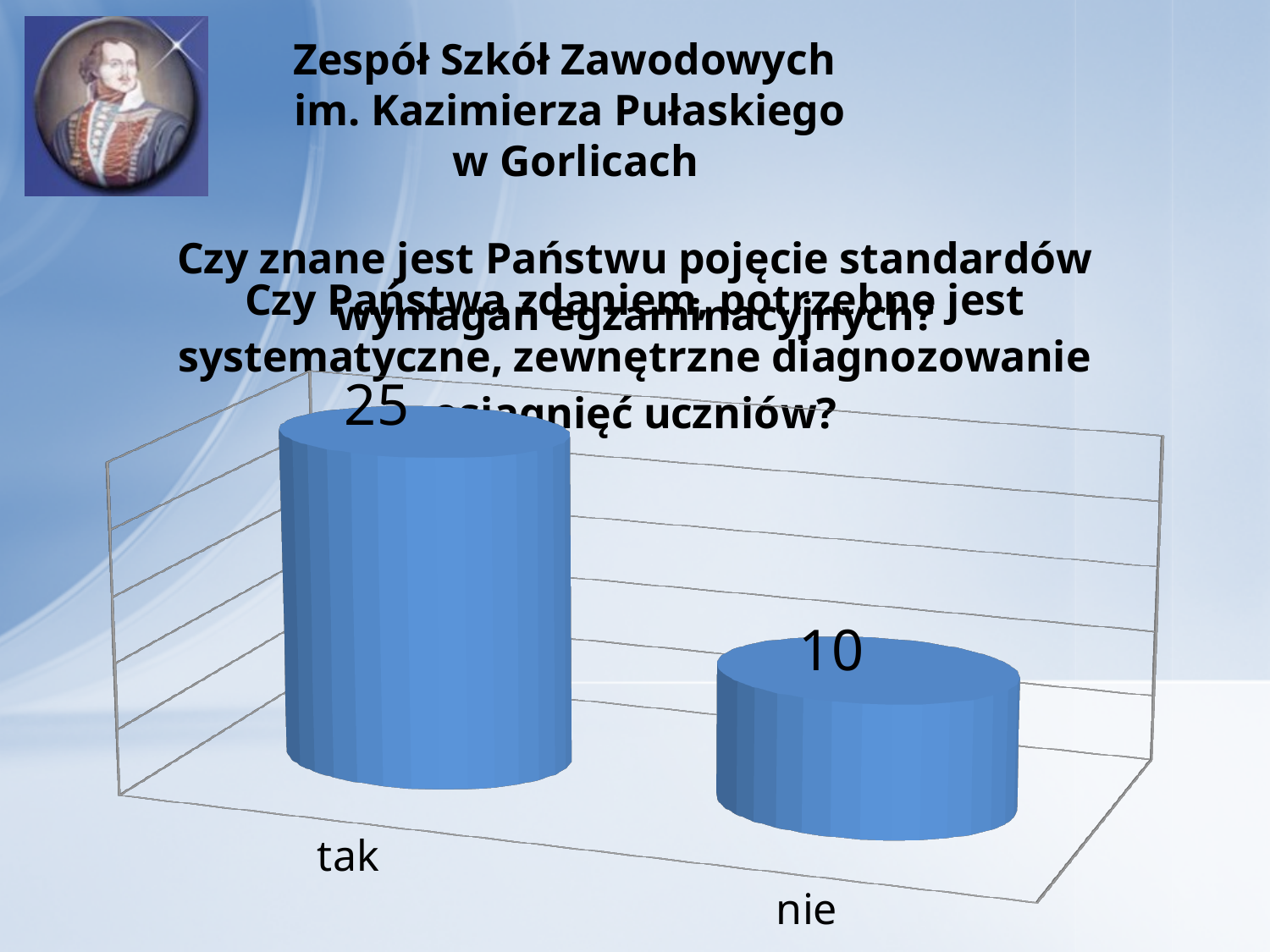
Which is larger, the value for "tak" or the value for "nie"? tak What is the value for "nie"? 10 What are the category labels on the x axis, from left to right? tak, nie Do the values rise or fall from "tak" to "nie"? fall What is the difference between the values for "tak" and "nie"? 15 Which category has the highest value? tak What colour are the bars in the chart? blue How many categories are shown in the chart? 2 What kind of chart is shown on the slide? bar chart Which category has the lowest value? nie What is the value for "tak"? 25 What is the total of the values for "tak" and "nie"? 35